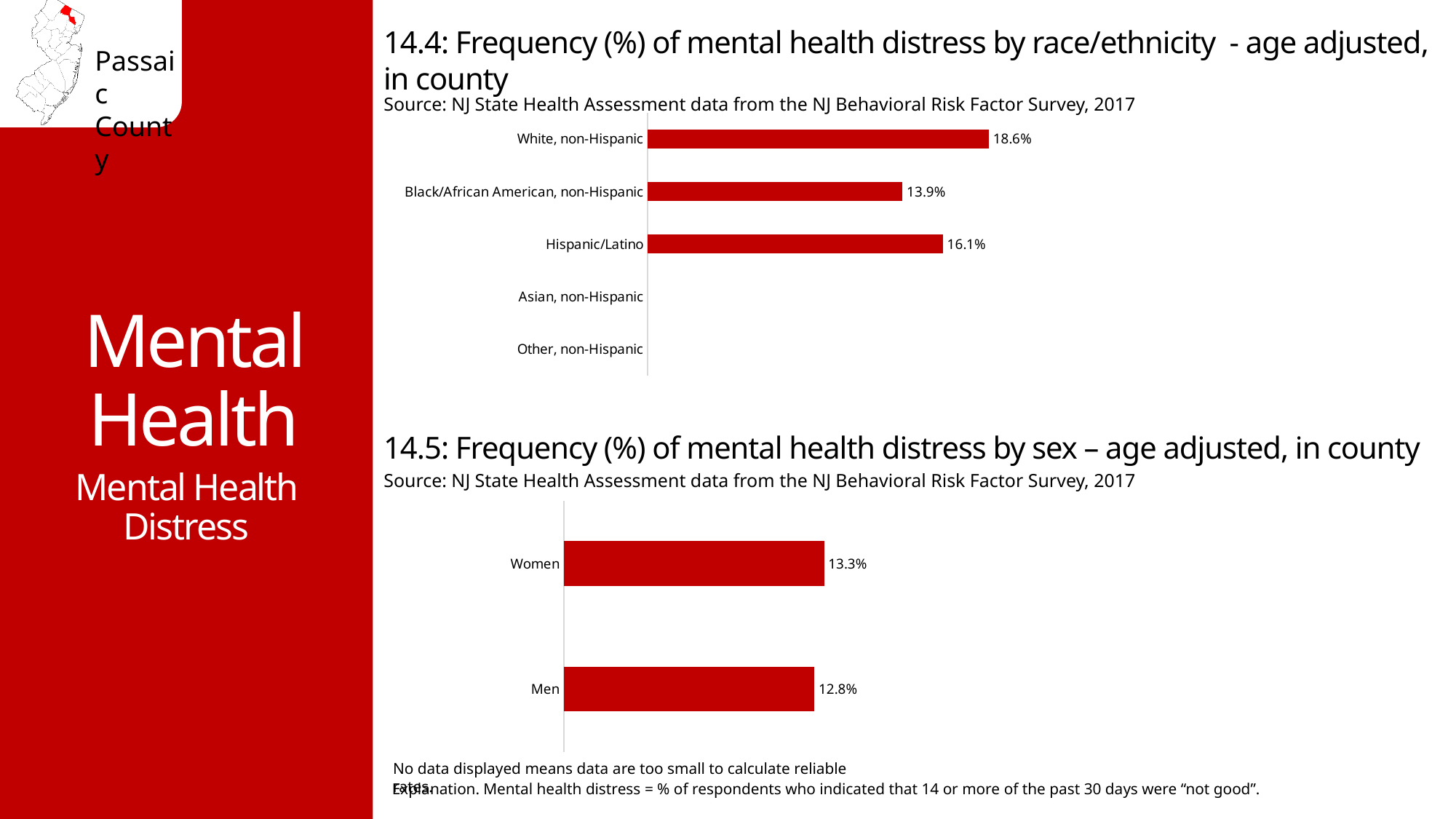
In the chart 14.4 (mental health distress by race/ethnicity), what is the difference between the White, non-Hispanic and Hispanic/Latino values? 2.5% In the chart 14.5 (mental health distress by sex), what is the difference between the Women and Men values? 0.5% In the chart 14.5 (mental health distress by sex), what is the value for Women? 13.3% In the chart 14.4 (mental health distress by race/ethnicity), which category with a displayed value has the lowest frequency? Black/African American, non-Hispanic In the chart 14.4 (mental health distress by race/ethnicity), which categories have no bar displayed? Asian, non-Hispanic and Other, non-Hispanic What type of chart is chart 14.5 (mental health distress by sex)? Bar chart In the chart 14.4 (mental health distress by race/ethnicity), how many race/ethnicity categories are listed on the axis? 5 In the chart 14.4 (mental health distress by race/ethnicity), what is the value for White, non-Hispanic? 18.6% In the chart 14.4 (mental health distress by race/ethnicity), what is the value for Black/African American, non-Hispanic? 13.9% In the chart 14.4 (mental health distress by race/ethnicity), what is the value for Hispanic/Latino? 16.1% In the chart 14.4 (mental health distress by race/ethnicity), which category with a displayed value has the highest frequency? White, non-Hispanic In the chart 14.5 (mental health distress by sex), what is the value for Men? 12.8%